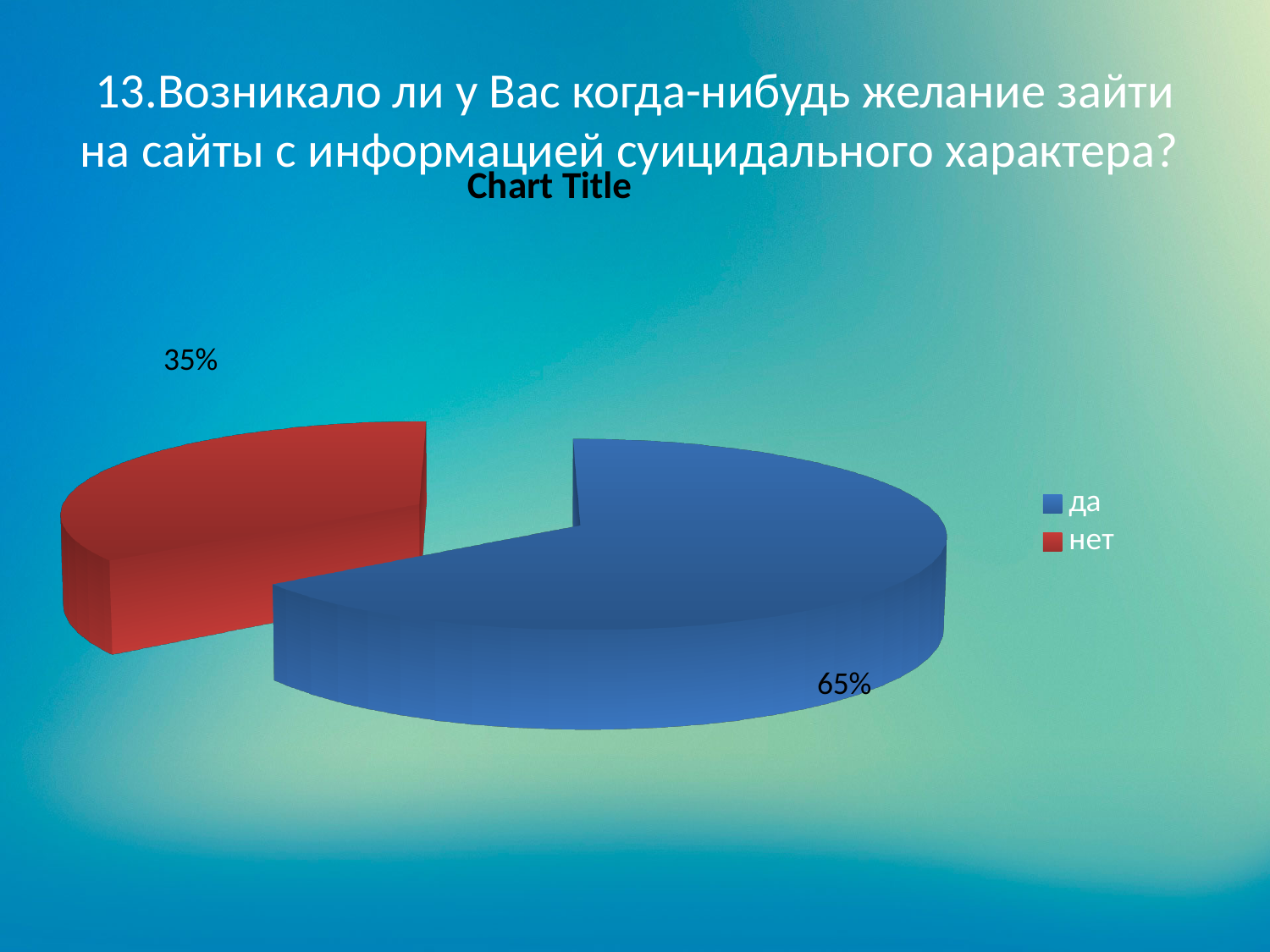
What share of the pie does "нет" have? 35% Which category has the smallest slice of the pie? нет Which is larger, the slice for "да" or the slice for "нет"? да What share of the pie does "да" have? 65% How many slices does the pie chart have? 2 What colour is the slice for "нет"? red Which category has the largest slice of the pie? да What kind of chart is shown on the slide? pie chart What is the title printed above the pie chart? Chart Title How many entries does the legend list? 2 What is the difference in percentage points between the "да" and "нет" slices? 30%